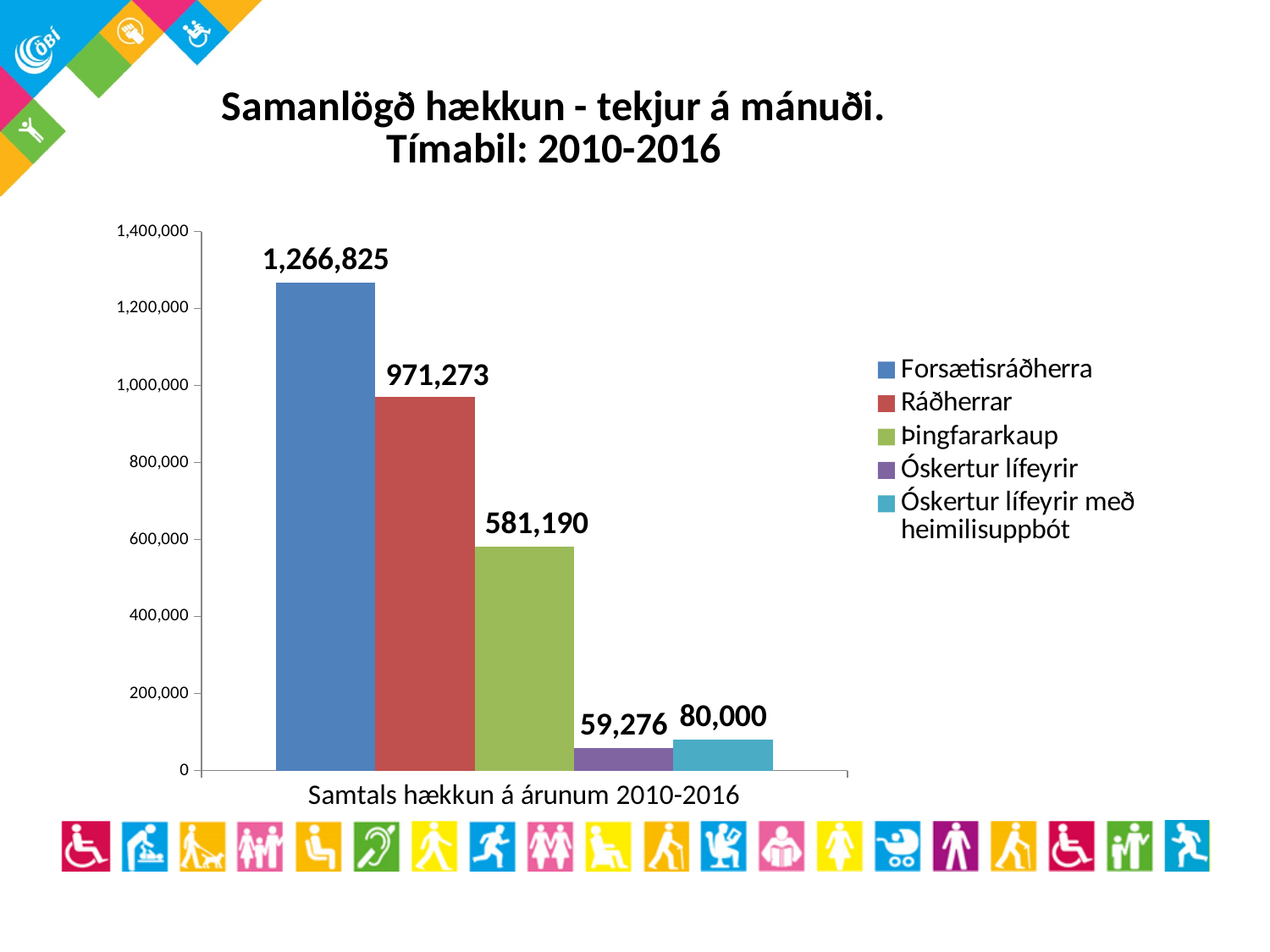
What kind of chart is shown on the slide? Bar chart What is the value for Þingfararkaup? 581,190 What is the value for Óskertur lífeyrir með heimilisuppbót? 80,000 Which series has the lowest value? Óskertur lífeyrir Which series has the highest value? Forsætisráðherra What is the value for Ráðherrar? 971,273 What is the value for Forsætisráðherra? 1,266,825 How many series does the legend list? 5 What is the title of the chart? Samanlögð hækkun - tekjur á mánuði. Tímabil: 2010-2016 Which is larger, the value for Þingfararkaup or the value for Óskertur lífeyrir með heimilisuppbót? Þingfararkaup What is the difference between the values for Forsætisráðherra and Ráðherrar? 295,552 What is the value for Óskertur lífeyrir? 59,276